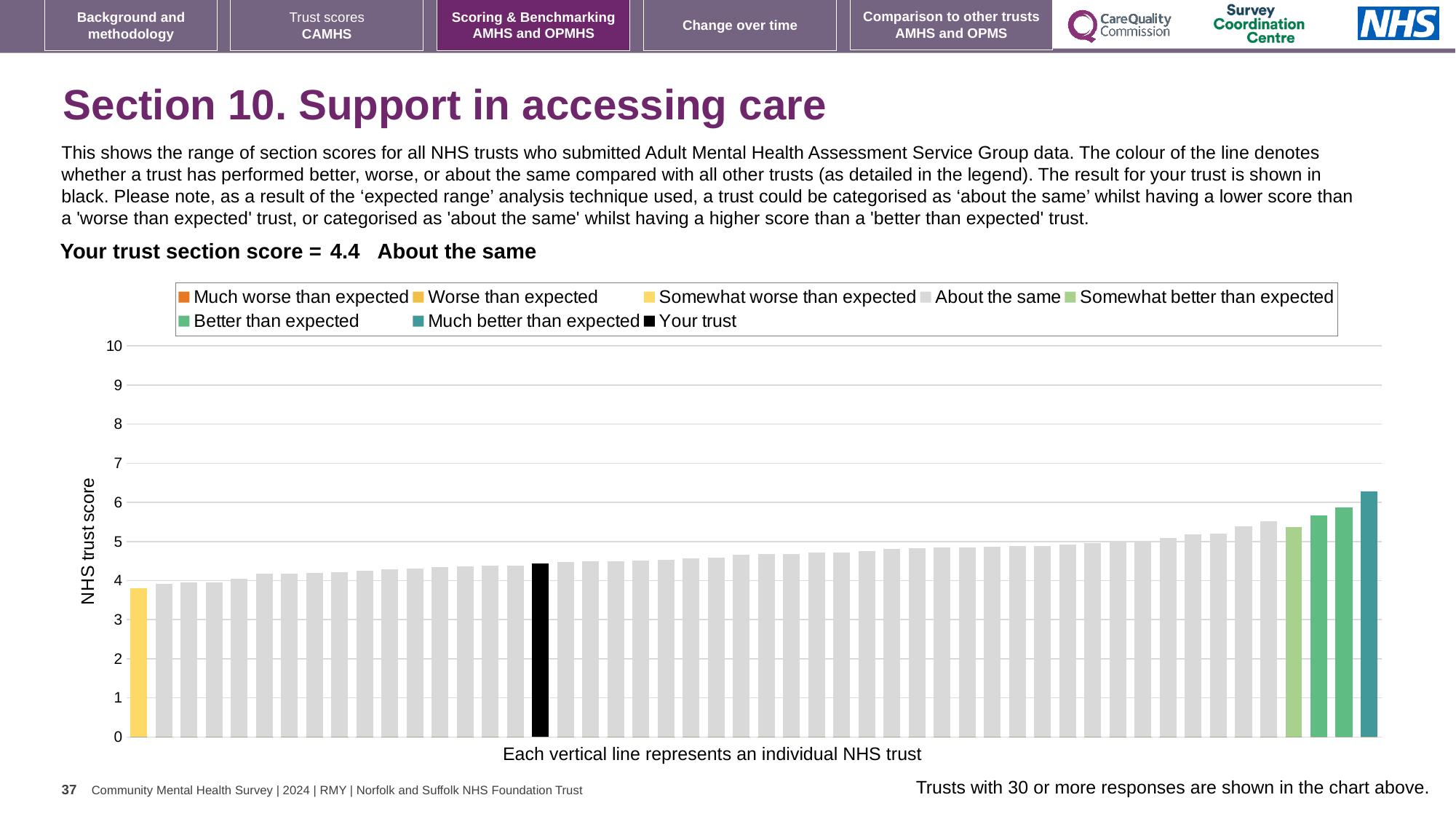
Is the value of the shortest bar greater or less than 4? less Is the value of the tallest bar greater or less than 6? greater What kind of chart is shown on the slide? bar chart Is the value for your trust greater or less than 5? less Which legend category does the tallest bar belong to? Much better than expected How is your trust's section score categorised compared with other trusts? About the same What colour is the bar representing your trust? black What is your trust's section score for Section 10, Support in accessing care? 4.4 How many bars are coloured as 'Better than expected'? 2 What is the label on the y axis of the chart? NHS trust score How many entries does the chart legend list? 8 Do the bar values rise or fall from left to right along the x axis? rise